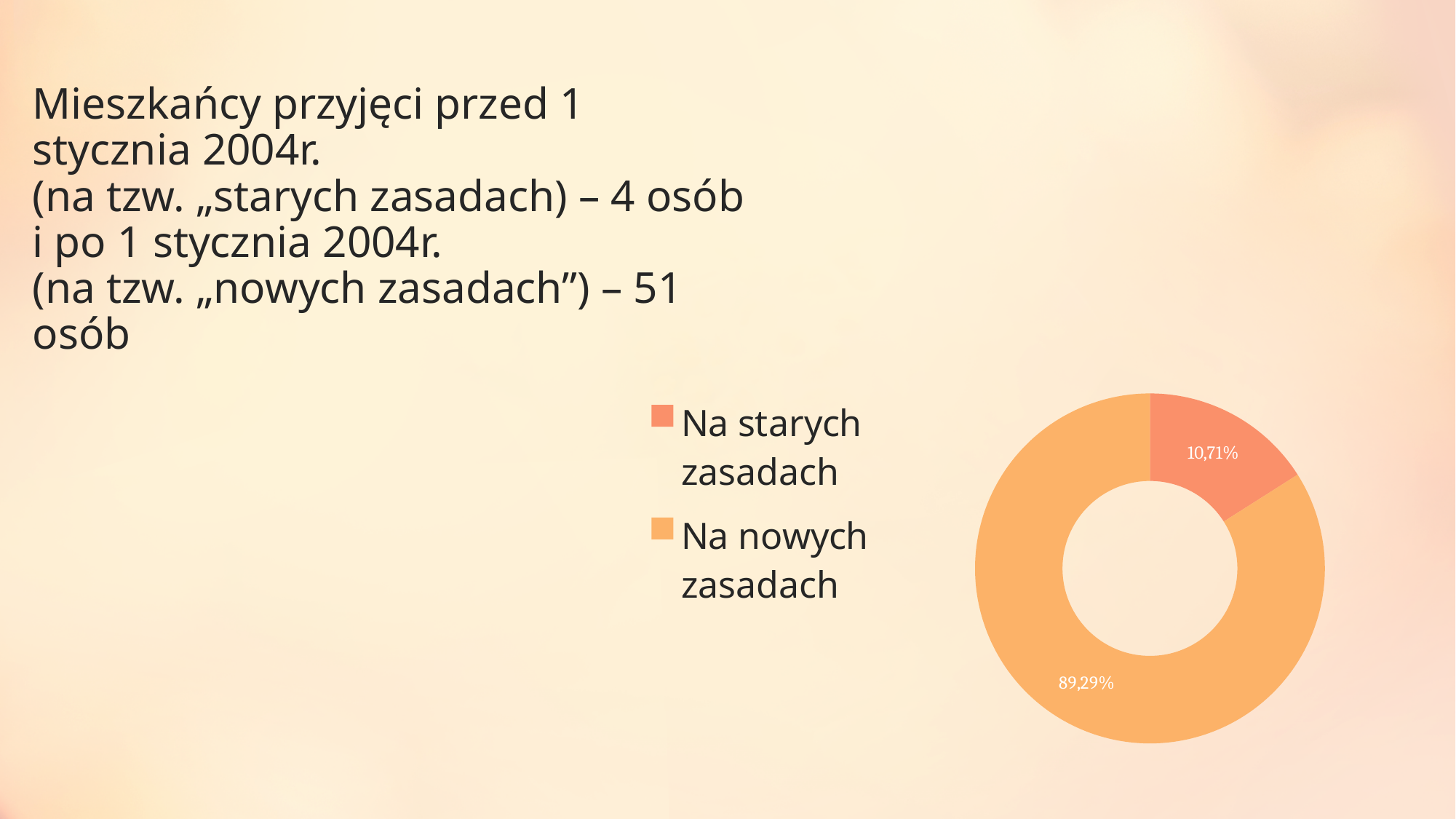
Where is the legend positioned relative to the chart? To the left of the chart Which is larger, the share for "Na starych zasadach" or for "Na nowych zasadach"? Na nowych zasadach What percentage is shown for "Na starych zasadach"? 10,71% Which category has the smallest share of the chart? Na starych zasadach What percentage is shown for "Na nowych zasadach"? 89,29% How many entries does the legend list? 2 How many slices does the chart have? 2 What share of the chart does the "Na starych zasadach" slice represent? 10,71% What kind of chart is shown on the slide? Doughnut chart Which legend entry is shown in the darker orange colour? Na starych zasadach Which category has the largest share of the chart? Na nowych zasadach What is the difference in percentage points between "Na nowych zasadach" and "Na starych zasadach"? 78,58